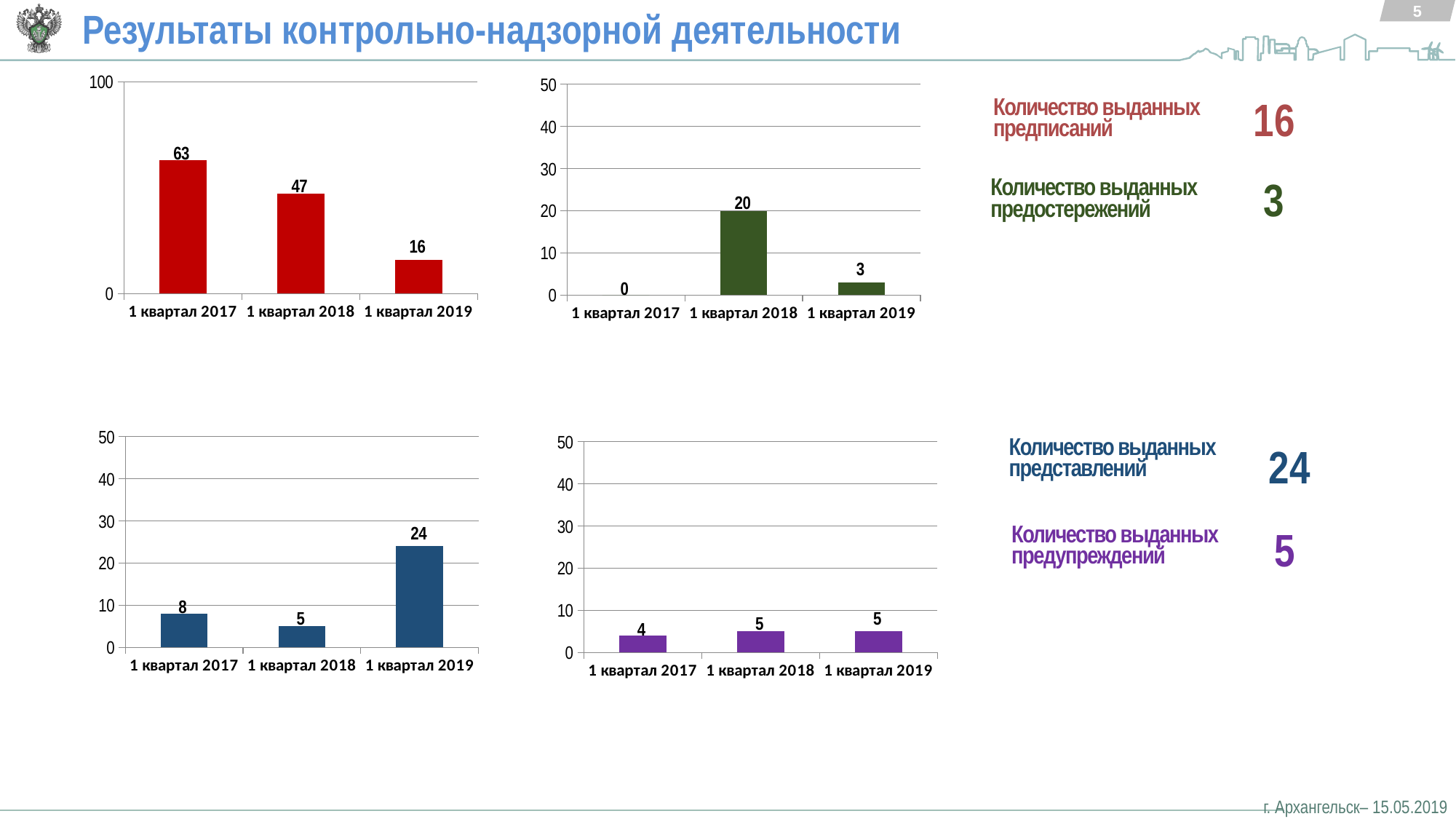
In the top-left chart (red bars), what is the value for 1 квартал 2019? 16 In the top-right chart (green bars), what is the difference between the values for 1 квартал 2018 and 1 квартал 2019? 17 In the top-left chart (red bars), what is the difference between the values for 1 квартал 2017 and 1 квартал 2018? 16 In the bottom-right chart (purple bars), what is the value for 1 квартал 2017? 4 In the top-right chart (green bars), which quarter has the lowest value? 1 квартал 2017 In the top-left chart (red bars), do the values rise or fall from 1 квартал 2017 to 1 квартал 2019? fall In the bottom-left chart (blue bars), what is the value for 1 квартал 2017? 8 In the bottom-left chart (blue bars), which quarter has the highest value? 1 квартал 2019 In the top-left chart (red bars), what is the value for 1 квартал 2017? 63 In the top-right chart (green bars), what is the value for 1 квартал 2018? 20 How many categories are shown on the x axis of the bottom-right chart (purple bars)? 3 What kind of chart is the bottom-left chart (blue bars)? bar chart